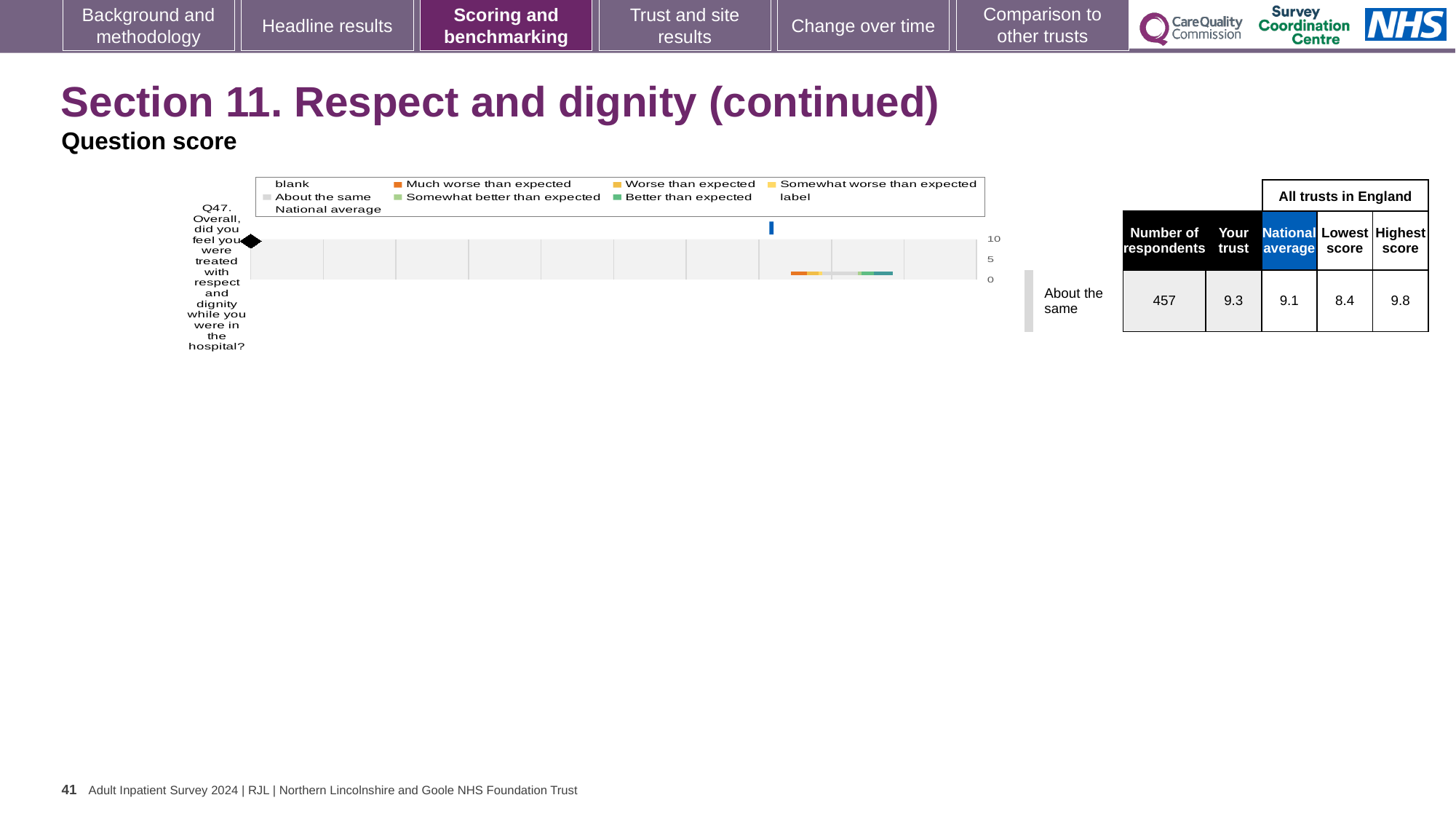
How many questions (categories) are plotted on the chart? 1 What is the lowest score among all trusts in England for Q47? 8.4 What is the national average score for Q47 shown in the table beside the chart? 9.1 What is the 'Your trust' score for Q47 shown in the table beside the chart? 9.3 What is the difference between the highest score and the lowest score among all trusts in England for Q47? 1.4 What kind of chart is shown on the slide? bar chart What benchmarking category is Q47 assigned to on the slide? About the same What is the number of respondents for Q47 shown in the table beside the chart? 457 Which question number is plotted on the chart? Q47 What is the highest tick value shown on the chart's score axis? 10 What is the highest score among all trusts in England for Q47? 9.8 Which is larger for Q47, the 'Your trust' score or the national average? Your trust